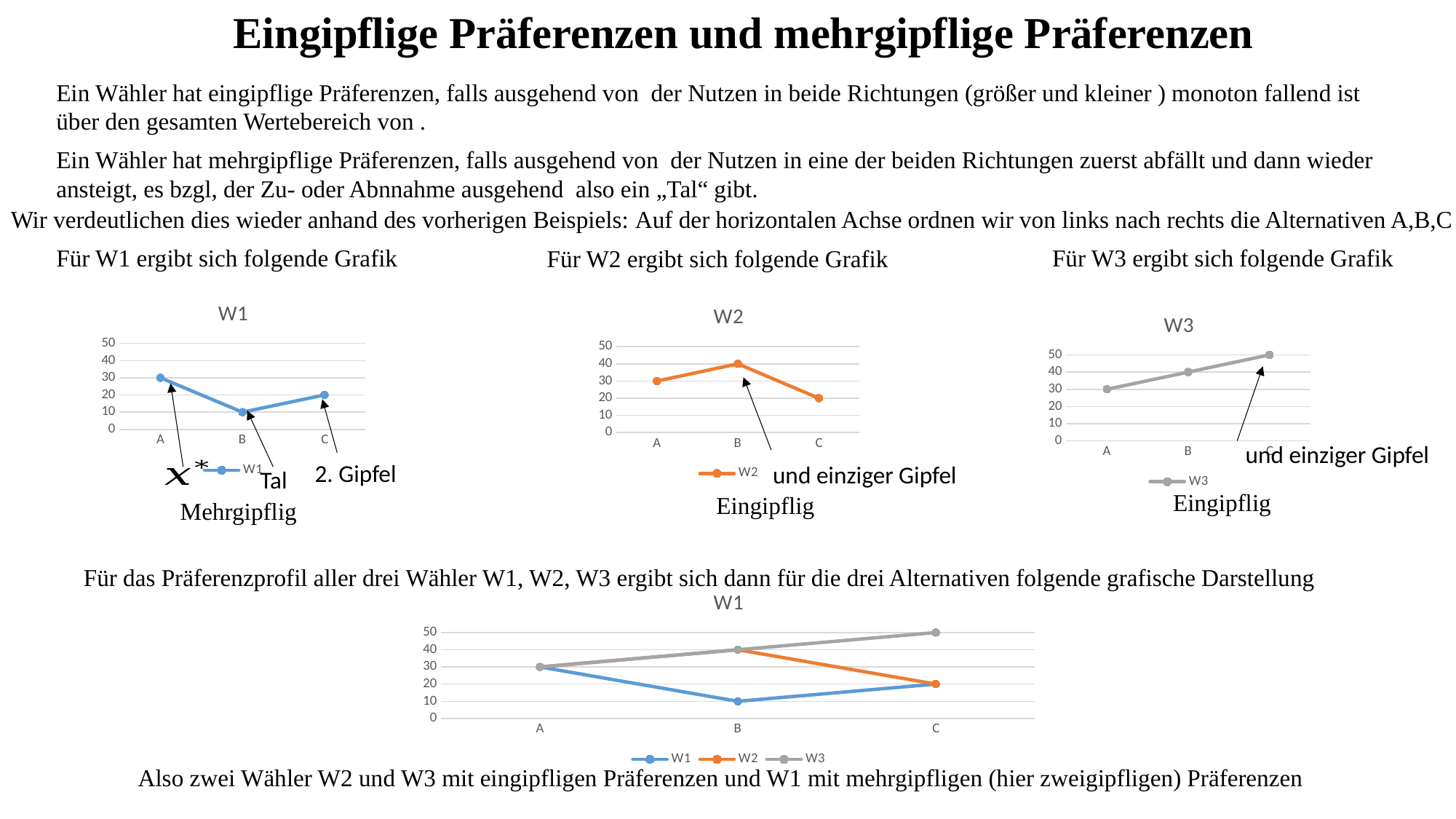
In the bottom chart, what is the value of the W3 series at B? 40 In the top-middle chart titled W2, what is the value for B? 40 In the top-left chart titled W1, what is the difference between the values for A and B? 20 What kind of chart is the bottom chart? line chart In the top-left chart titled W1, what is the value for B? 10 In the top-middle chart titled W2, which category has the highest value? B In the top-right chart titled W3, what is the value for C? 50 In the top-left chart titled W1, which category has the lowest value? B How many series does the legend of the bottom chart list? 3 In the top-right chart titled W3, do the values rise or fall from A to C? rise In the top-middle chart titled W2, which is larger, the value for A or the value for C? A How many categories are shown on the x axis of the bottom chart? 3